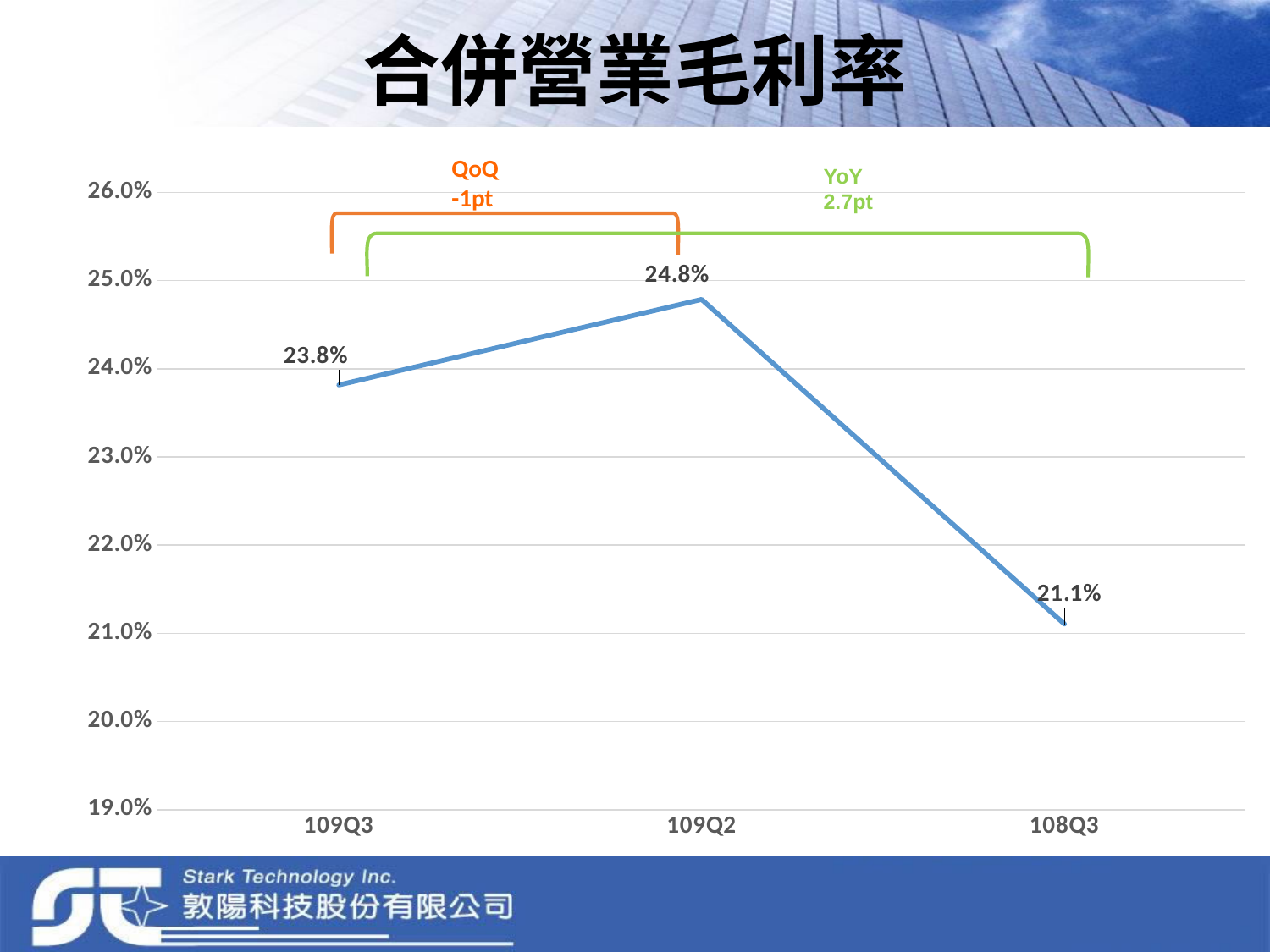
Which period has the lowest value? 108Q3 What is the difference between the values for 109Q2 and 109Q3? 1.0% What kind of chart is shown on the slide? line chart How many periods are plotted on the chart? 3 What is the title of the chart? 合併營業毛利率 Which period has the highest value? 109Q2 What is the value for 108Q3? 21.1% Which is larger, the value for 109Q3 or the value for 108Q3? 109Q3 What is the value for 109Q2? 24.8% What is the value for 109Q3? 23.8% Is the value for 108Q3 greater or less than 22.0%? less What is the difference between the values for 109Q3 and 108Q3? 2.7%